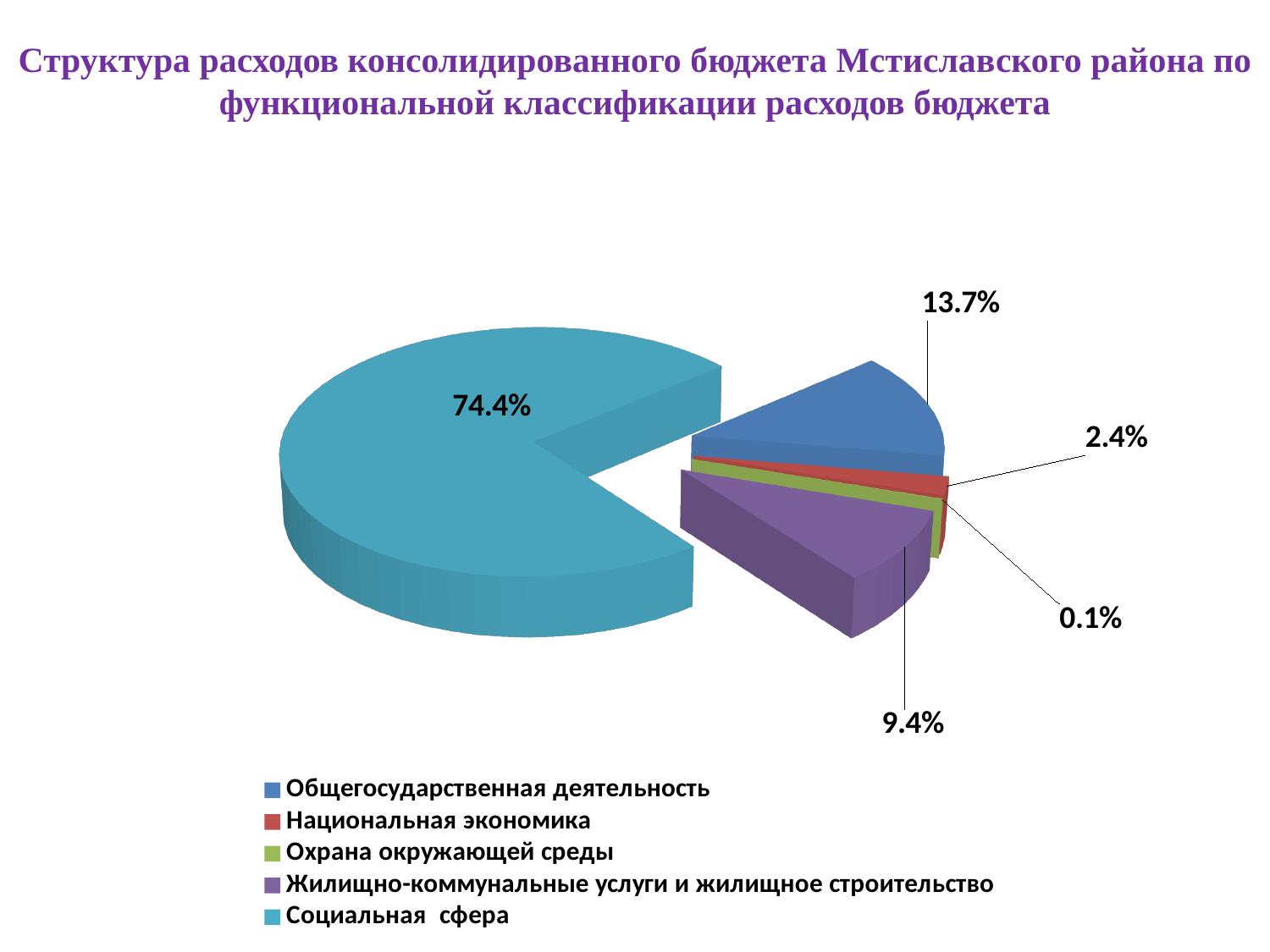
Which is larger: the share for Национальная экономика or the share for Жилищно-коммунальные услуги и жилищное строительство? Жилищно-коммунальные услуги и жилищное строительство Which category has the smallest share of the pie? Охрана окружающей среды What share of expenditures goes to Социальная сфера? 74.4% What kind of chart is shown on the slide? pie chart What is the value for Жилищно-коммунальные услуги и жилищное строительство? 9.4% How many categories does the legend list? 5 What is the value for Общегосударственная деятельность? 13.7% What colour is the slice for Социальная сфера? light blue (cyan) What is the difference between the shares of Общегосударственная деятельность and Жилищно-коммунальные услуги и жилищное строительство? 4.3% What is the value for Охрана окружающей среды? 0.1% Which category has the largest share of the pie? Социальная сфера What is the value for Национальная экономика? 2.4%